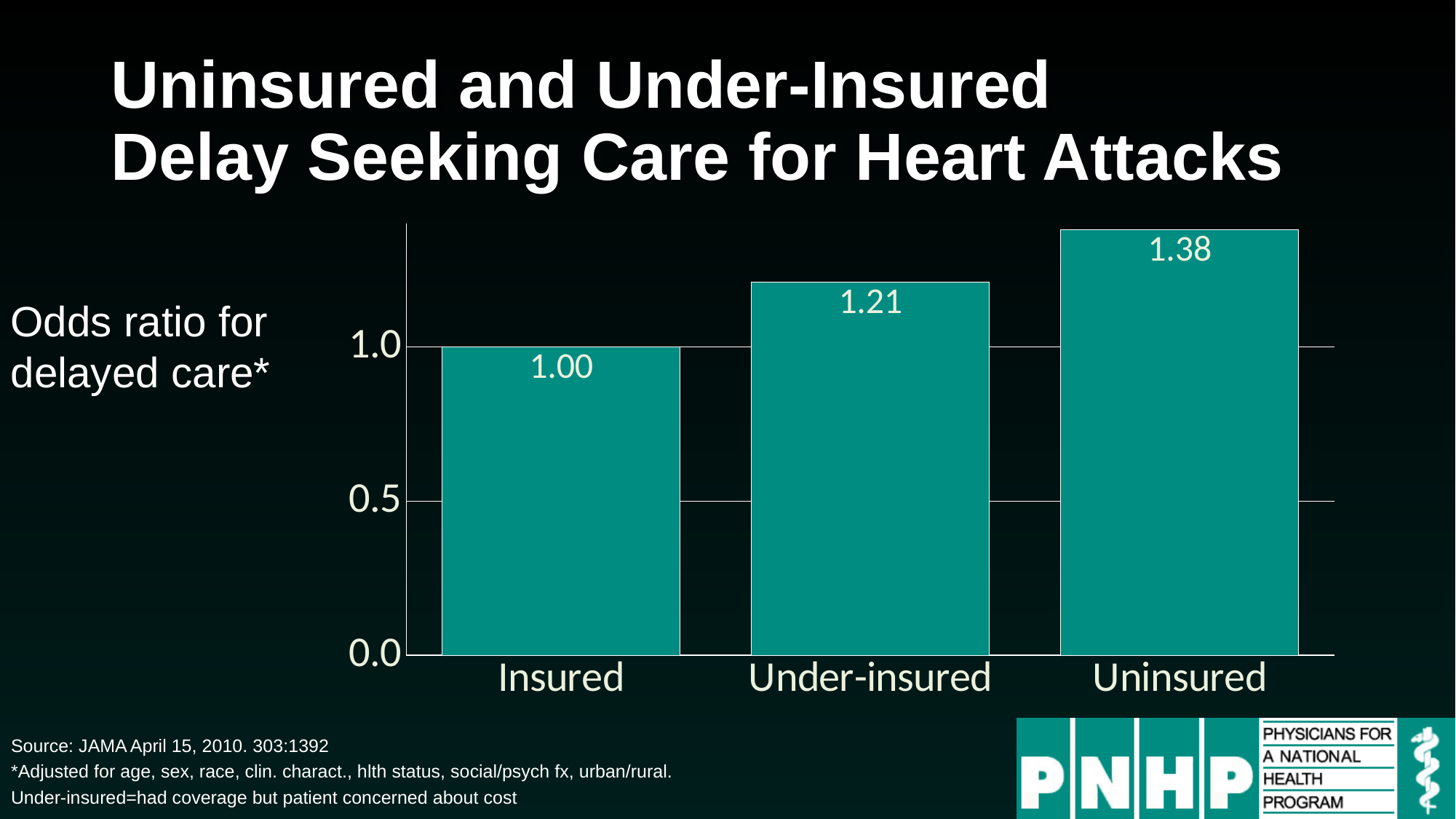
Do the odds ratios rise or fall moving from Insured to Uninsured along the x axis? Rise What is the odds ratio for delayed care for the Under-insured group? 1.21 Which group has a larger odds ratio for delayed care, Under-insured or Insured? Under-insured What is the difference between the odds ratios for the Uninsured and Under-insured groups? 0.17 What is the odds ratio for delayed care for the Insured group? 1.00 What is the odds ratio for delayed care for the Uninsured group? 1.38 What is the difference between the odds ratios for the Uninsured and Insured groups? 0.38 Which group has the highest odds ratio for delayed care? Uninsured Which group has the lowest odds ratio for delayed care? Insured How many groups are shown on the chart? 3 What kind of chart is shown on the slide? Bar chart Is the odds ratio for the Under-insured group greater or less than 1.0? greater